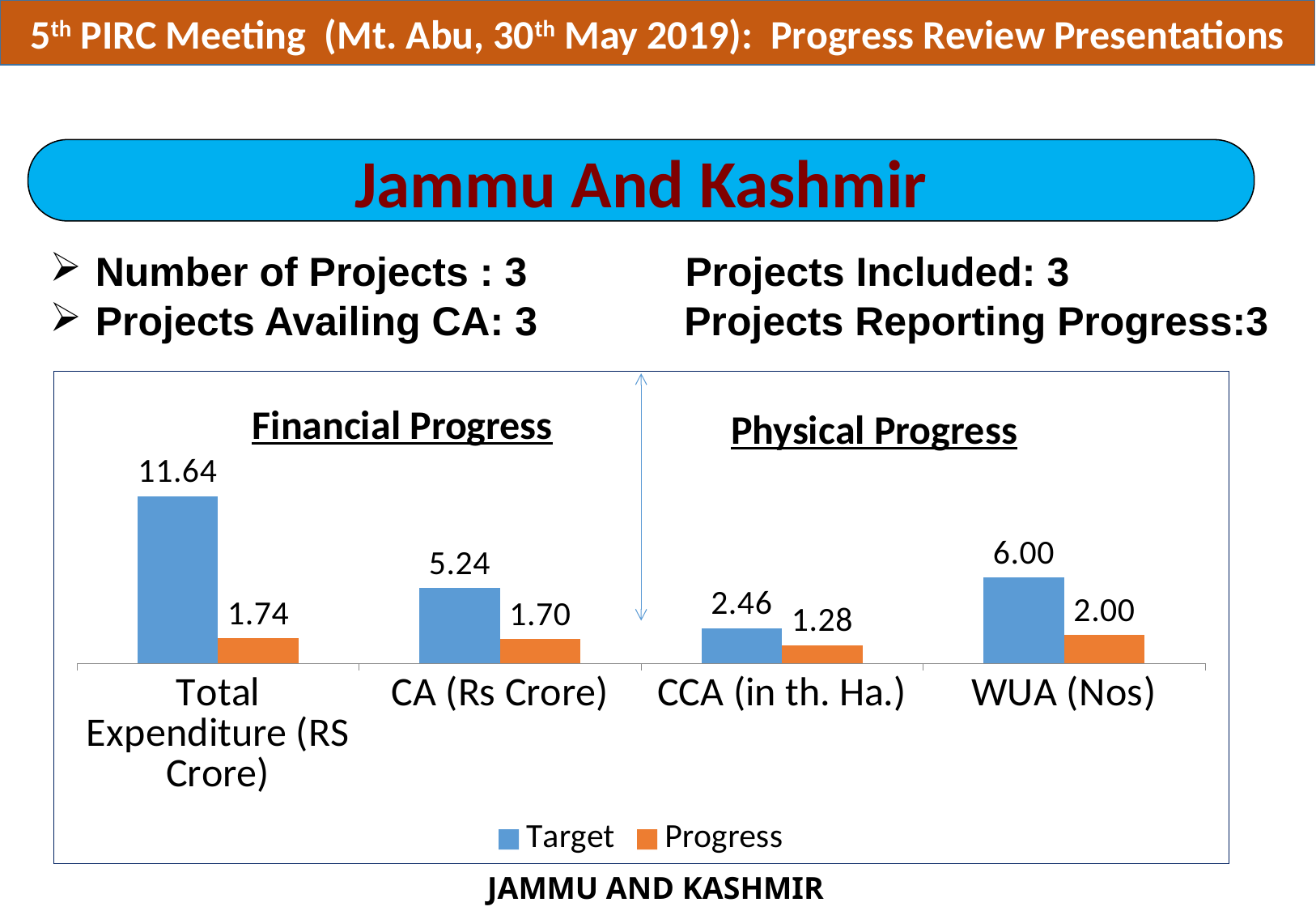
How many series does the chart legend list? 2 What is the Target value for Total Expenditure (RS Crore)? 11.64 What is the Progress value for CCA (in th. Ha.)? 1.28 What is the Target value for WUA (Nos)? 6.00 What is the Progress value for CA (Rs Crore)? 1.70 What is the difference between the Target and Progress values for Total Expenditure (RS Crore)? 9.90 What is the difference between the Target and Progress values for WUA (Nos)? 4.00 What kind of chart is shown on the slide? Bar chart How many categories are shown on the x axis of the chart? 4 Which category has the lowest Progress value? CCA (in th. Ha.) Which is larger, the Progress value for WUA (Nos) or the Progress value for Total Expenditure (RS Crore)? WUA (Nos) Which category has the highest Target value? Total Expenditure (RS Crore)